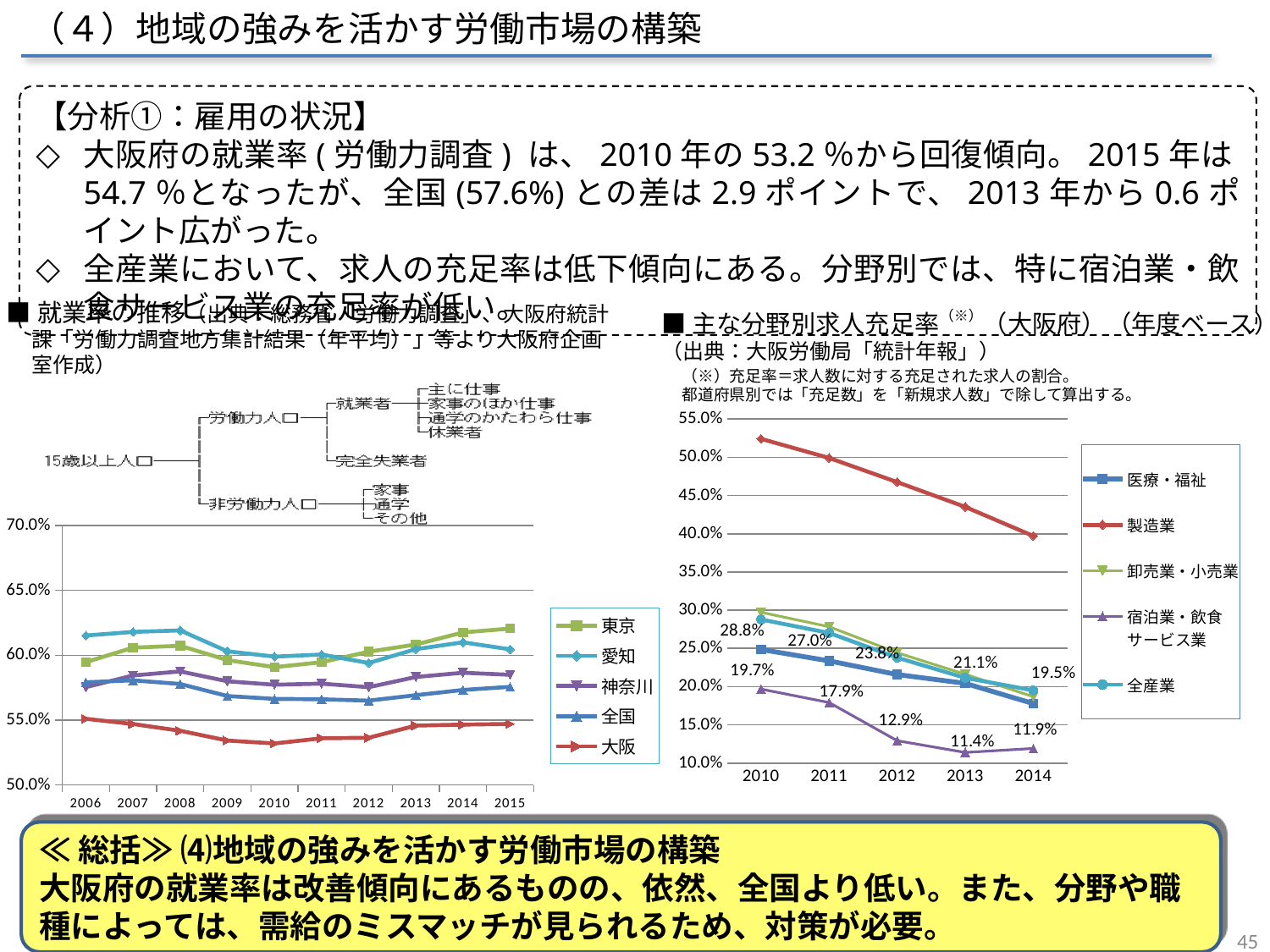
In the right chart (主な分野別求人充足率), what is the value for 宿泊業・飲食サービス業 in 2010? 19.7% In the left chart (就業率の推移), how many years are shown on the x axis? 10 In the left chart (就業率の推移), how many series does the legend list? 5 In the left chart (就業率の推移), which series has the highest value in 2015? 東京 In the right chart (主な分野別求人充足率), what is the value for 宿泊業・飲食サービス業 in 2013? 11.4% In the left chart (就業率の推移), which series has the lowest value in 2015? 大阪 In the left chart (就業率の推移), is the value for 大阪 in 2010 greater or less than 55.0%? less In the right chart (主な分野別求人充足率), what is the difference between the 宿泊業・飲食サービス業 values in 2010 and 2014? 7.8 points In the right chart (主な分野別求人充足率), which series has the highest value in 2010? 製造業 In the left chart (就業率の推移), what kind of chart is it? line chart In the right chart (主な分野別求人充足率), does the value for 製造業 rise or fall from 2010 to 2014? fall In the left chart (就業率の推移), is the value for 東京 in 2015 greater or less than 60.0%? greater